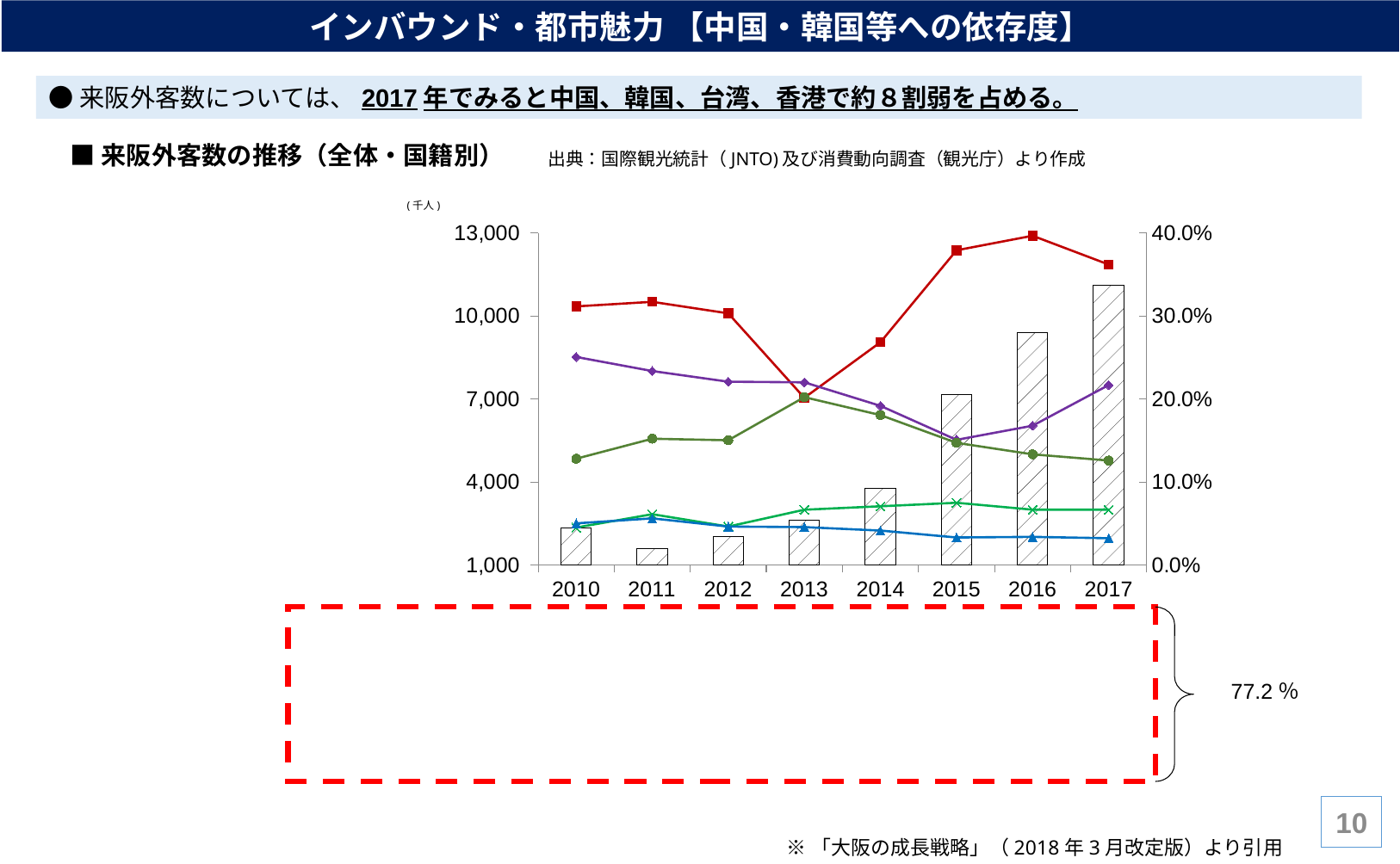
Do the bars rise or fall from 2013 to 2017? rise Is the bar for 2013 greater or less than 4,000 on the left axis? less In which year does the red line reach its highest point? 2016 What kind of chart is shown on the slide? Combination bar and line chart Is the bar for 2016 greater or less than 10,000 on the left axis? less Which bar is taller, 2015 or 2016? 2016 Which year has the tallest bar in the chart? 2017 Is the bar for 2017 greater or less than 10,000 on the left axis? greater How many years are shown on the x axis of the chart? 8 What unit is shown above the left axis of the chart? 千人 Which year has the shortest bar in the chart? 2011